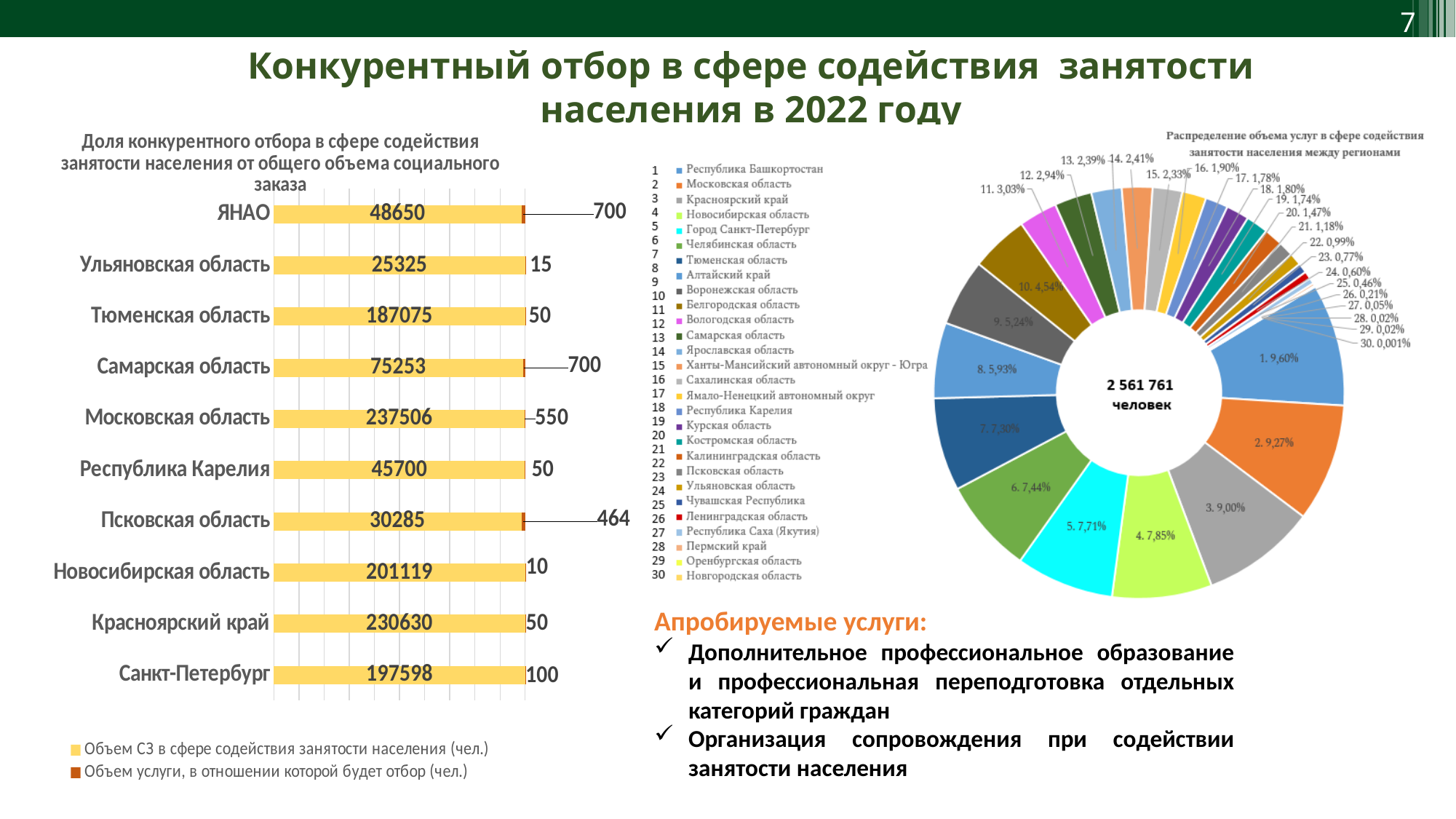
In the bar chart on the left, how many regions are shown? 10 In the bar chart on the left, which region has the lowest value of 'Объем СЗ в сфере содействия занятости населения (чел.)'? Ульяновская область In the bar chart on the left, which region has the highest value of 'Объем СЗ в сфере содействия занятости населения (чел.)'? Московская область What type of chart is 'Распределение объема услуг в сфере содействия занятости населения между регионами' on the right? Doughnut chart In the bar chart on the left, what is the value of 'Объем услуги, в отношении которой будет отбор (чел.)' for Псковская область? 464 In the bar chart on the left, how many series does the legend list? 2 In the bar chart on the left, which region has the lowest value of 'Объем услуги, в отношении которой будет отбор (чел.)'? Новосибирская область In the doughnut chart on the right, what total number of people is shown in the centre? 2 561 761 человек In the bar chart on the left, what is the difference between the 'Объем СЗ' values for Красноярский край and Санкт-Петербург? 33032 In the bar chart on the left, what is the value of 'Объем СЗ в сфере содействия занятости населения (чел.)' for Московская область? 237506 In the bar chart on the left, what is the value of 'Объем СЗ в сфере содействия занятости населения (чел.)' for Тюменская область? 187075 In the doughnut chart on the right, what share does slice 1 (Республика Башкортостан) have? 9,60%